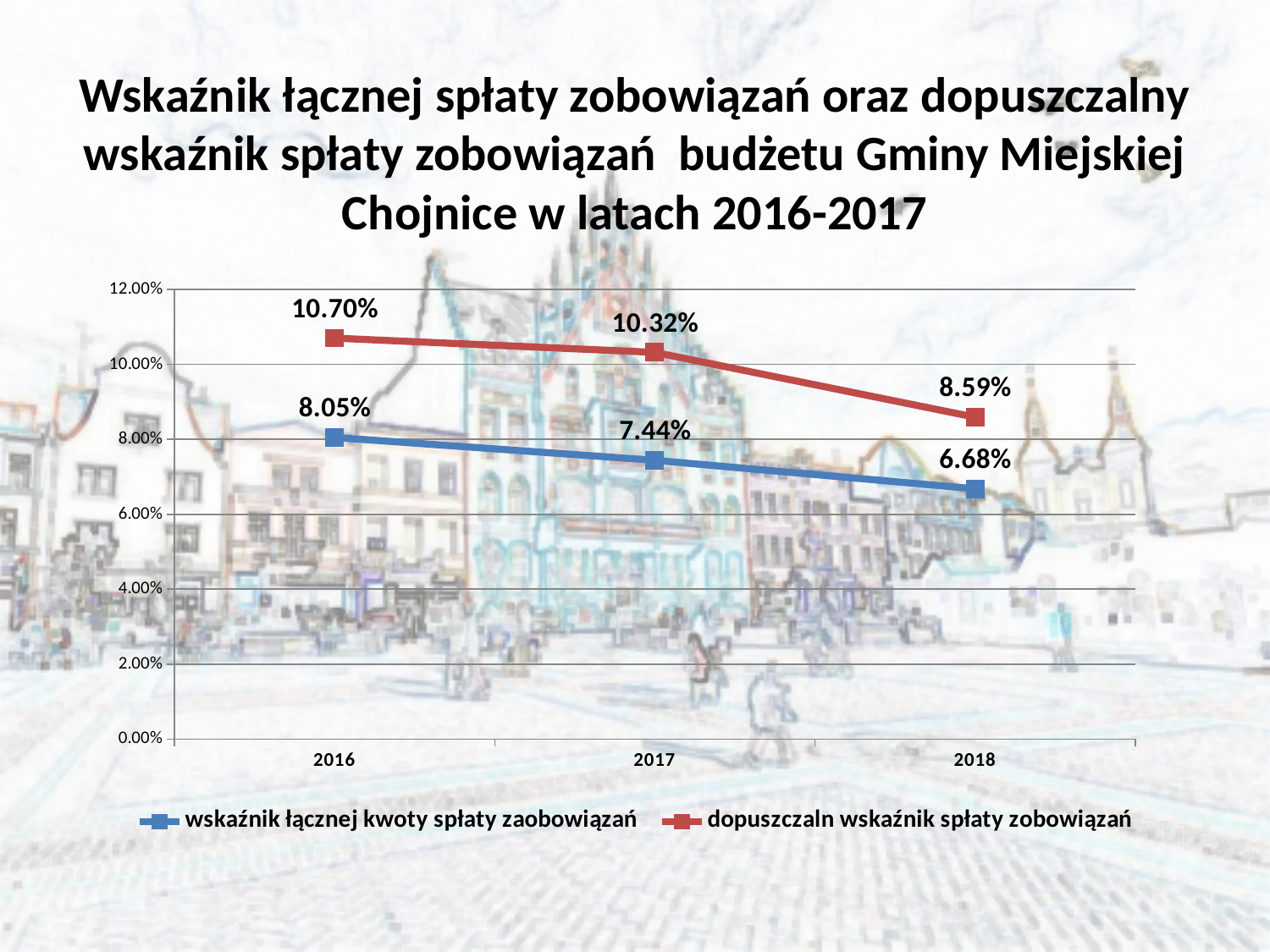
What is the value of 'wskaźnik łącznej kwoty spłaty zaobowiązań' in 2016? 8.05% What is the value of 'wskaźnik łącznej kwoty spłaty zaobowiązań' in 2018? 6.68% What is the difference between the two series in 2016? 2.65% Do the values of 'wskaźnik łącznej kwoty spłaty zaobowiązań' rise or fall from 2016 to 2018? fall In which year is 'dopuszczaln wskaźnik spłaty zobowiązań' highest? 2016 How many series does the legend list? 2 How many years are shown on the x axis? 3 Which series has the larger value in 2017? dopuszczaln wskaźnik spłaty zobowiązań In which year is 'wskaźnik łącznej kwoty spłaty zaobowiązań' lowest? 2018 What is the value of 'dopuszczaln wskaźnik spłaty zobowiązań' in 2018? 8.59% What kind of chart is shown on the slide? line chart What is the value of 'dopuszczaln wskaźnik spłaty zobowiązań' in 2017? 10.32%